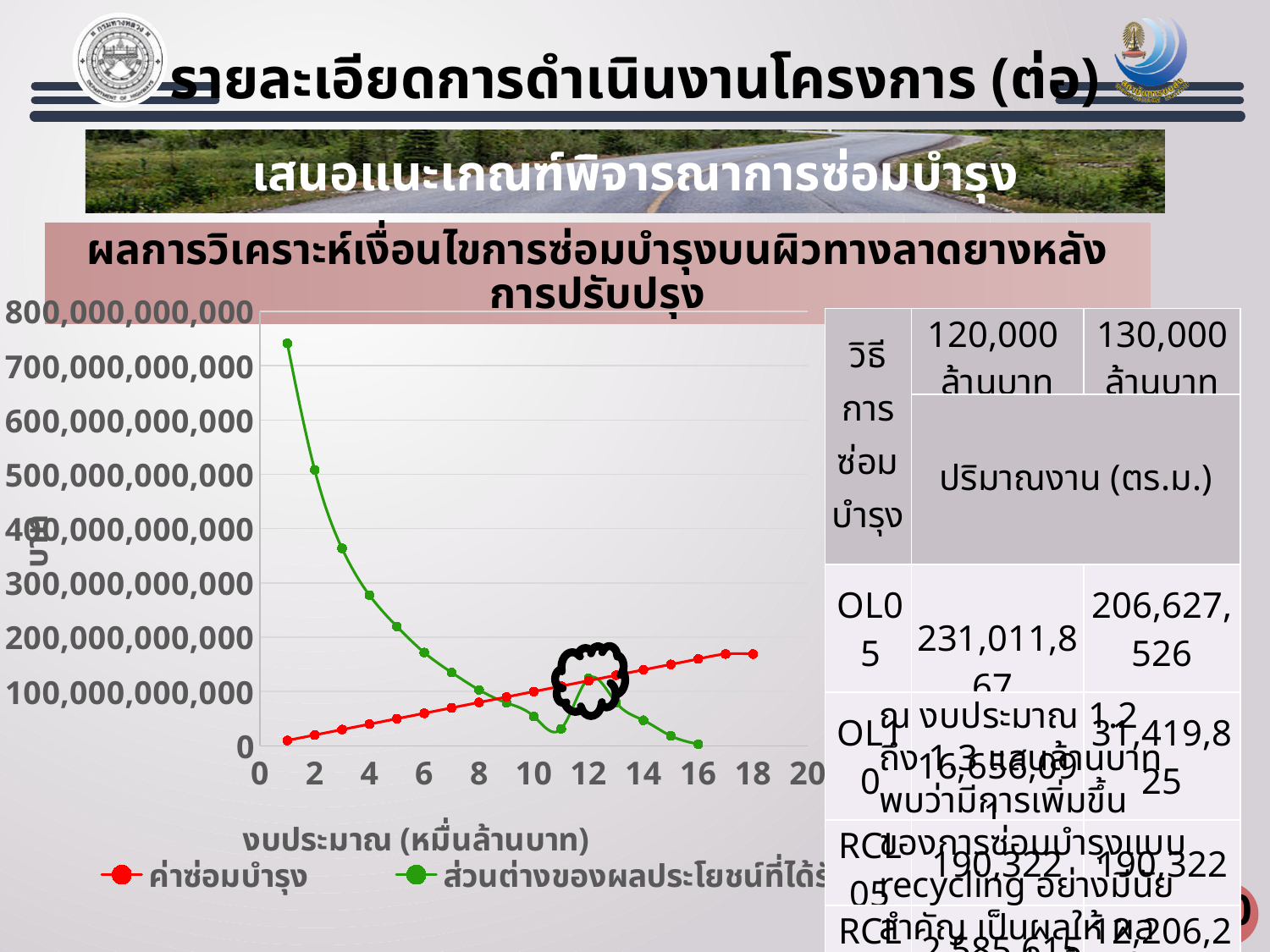
What is the x-axis title of the chart? งบประมาณ (หมื่นล้านบาท) How many series does the chart legend list? 2 At which x-axis value does the green series reach its highest point? 1 Is the value of the green series at x = 1 greater or less than 700,000,000,000? greater At x = 2, which series has the larger value, the red ค่าซ่อมบำรุง series or the green series? the green series What kind of chart is shown on the slide? line chart Does the red ค่าซ่อมบำรุง series rise or fall as the budget on the x axis increases? rise Is the value of the red ค่าซ่อมบำรุง series at x = 18 greater or less than 200,000,000,000? less Does the green series rise or fall overall as the budget on the x axis increases? fall At x = 16, which series has the larger value, the red ค่าซ่อมบำรุง series or the green series? the red ค่าซ่อมบำรุง series At which x-axis value does the red ค่าซ่อมบำรุง series reach its highest point? 17 and 18 (the series plateaus at the same value at both) Which series is drawn in red in the chart? ค่าซ่อมบำรุง